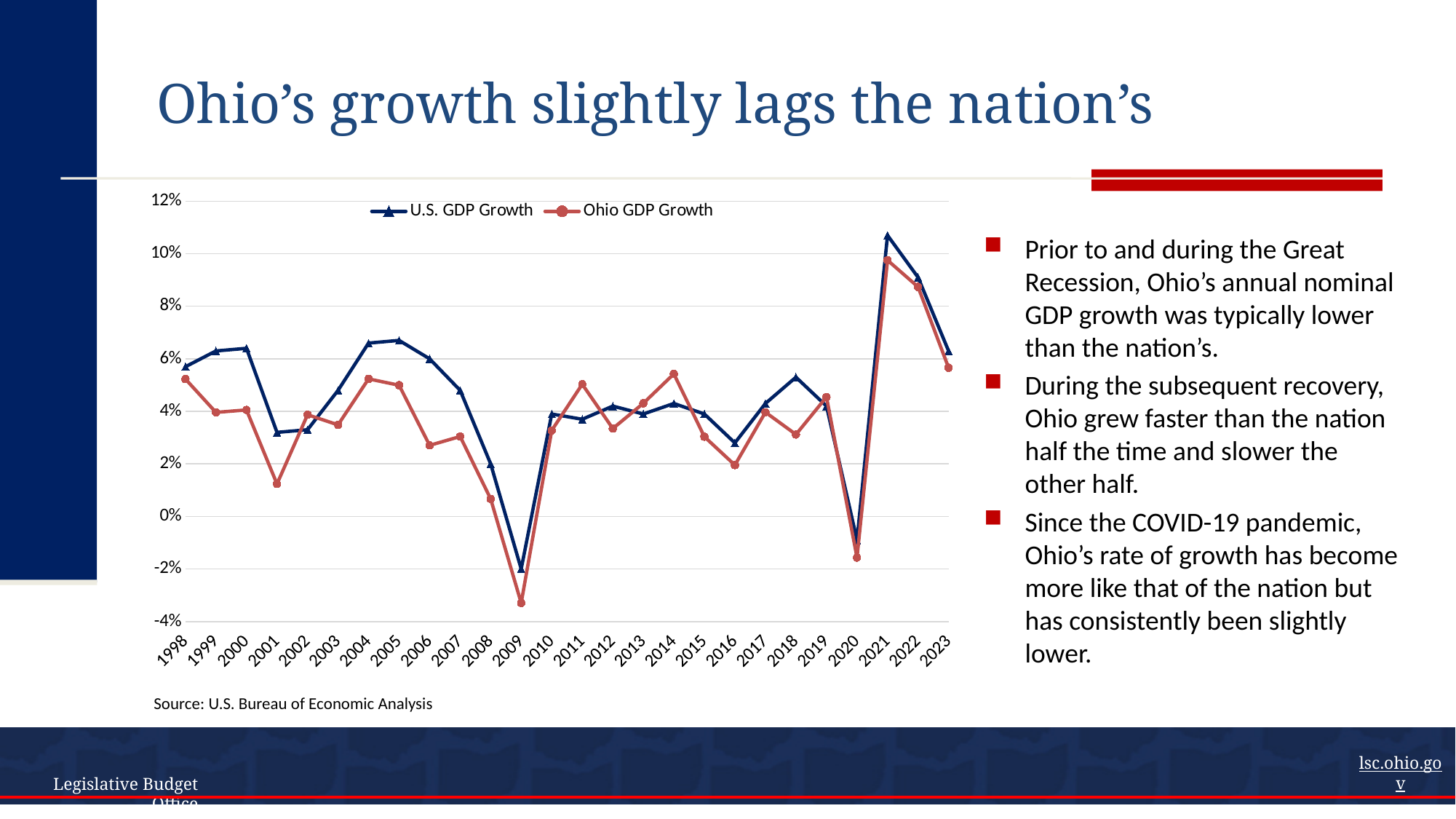
How many years are plotted along the x axis of the chart? 26 What kind of chart is shown on the slide? Line chart In which year does the Ohio GDP Growth series reach its lowest value? 2009 What are the two series named in the chart legend? U.S. GDP Growth and Ohio GDP Growth In 2014, which series has the higher value, U.S. GDP Growth or Ohio GDP Growth? Ohio GDP Growth How many series does the chart legend list? 2 In which year does the U.S. GDP Growth series reach its highest value? 2021 Do both series rise or fall from 2021 to 2023? fall In 2018, which series has the higher value, U.S. GDP Growth or Ohio GDP Growth? U.S. GDP Growth Is the U.S. GDP Growth value for 2021 greater or less than 10%? greater Is the Ohio GDP Growth value for 2009 greater or less than -2%? less Is the Ohio GDP Growth value for 2001 greater or less than 2%? less